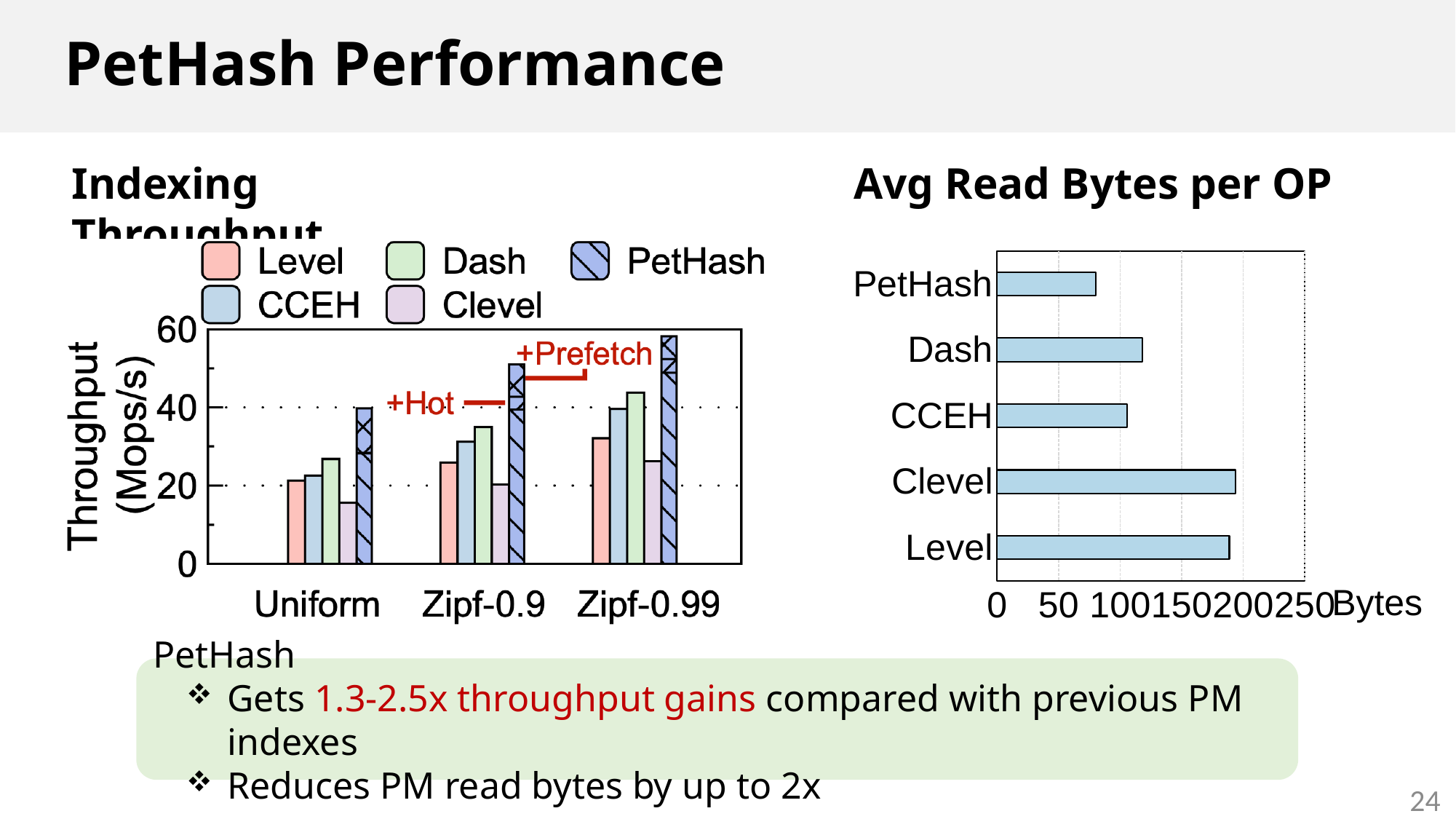
On the Avg Read Bytes per OP chart, which has more average read bytes, Dash or CCEH? Dash On the Indexing Throughput chart, what kind of chart is it? bar chart On the Indexing Throughput chart, how many series does the legend list? 5 On the Avg Read Bytes per OP chart, is the value for Clevel greater or less than 150? greater On the Indexing Throughput chart, does the PetHash throughput rise or fall from Uniform to Zipf-0.99? rise On the Indexing Throughput chart, how many workload categories are shown on the x axis? 3 On the Indexing Throughput chart, which series has the highest throughput for the Uniform workload? PetHash On the Avg Read Bytes per OP chart, how many indexes are shown? 5 On the Indexing Throughput chart, is the PetHash value for Zipf-0.9 greater or less than 40? greater On the Avg Read Bytes per OP chart, which index has the lowest average read bytes? PetHash On the Indexing Throughput chart, which series has the lowest throughput for the Uniform workload? Clevel On the Indexing Throughput chart, is the Clevel value for Zipf-0.99 greater or less than 40? less